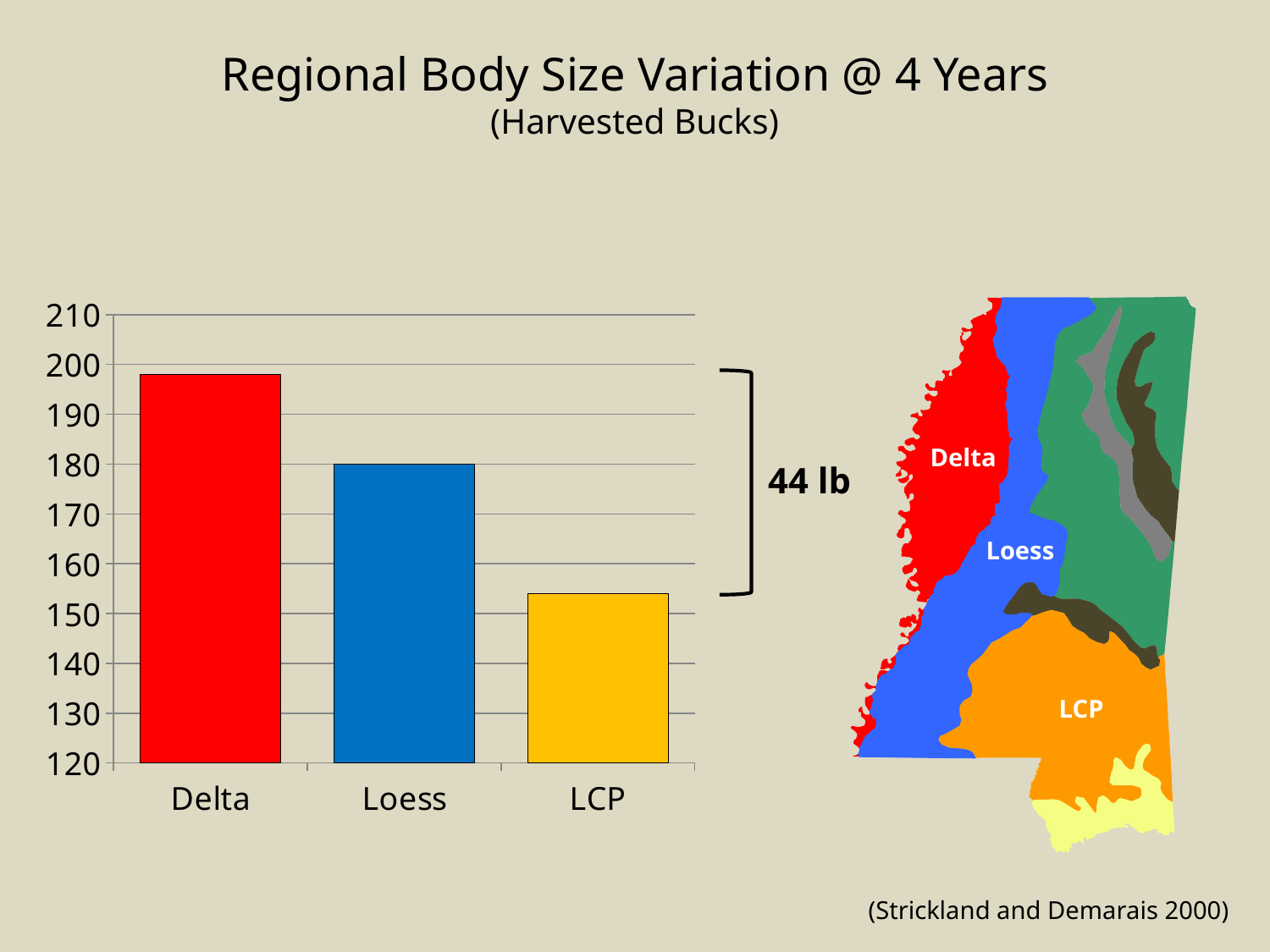
Is the value for Delta greater or less than 190? greater Which is larger, the value for Delta or the value for Loess? Delta Do the bar values rise or fall from left to right across Delta, Loess and LCP? fall What is the value for Loess in the bar chart? 180 What is the title of the chart on the slide? Regional Body Size Variation @ 4 Years (Harvested Bucks) How many regions are plotted in the bar chart? 3 Which region has the highest body size value in the bar chart? Delta Is the value for Delta greater or less than 200? less Is the value for LCP greater or less than 160? less According to the annotation on the slide, what is the difference in body size between Delta and LCP? 44 lb Which region has the lowest body size value in the bar chart? LCP What kind of chart is shown on the slide? bar chart